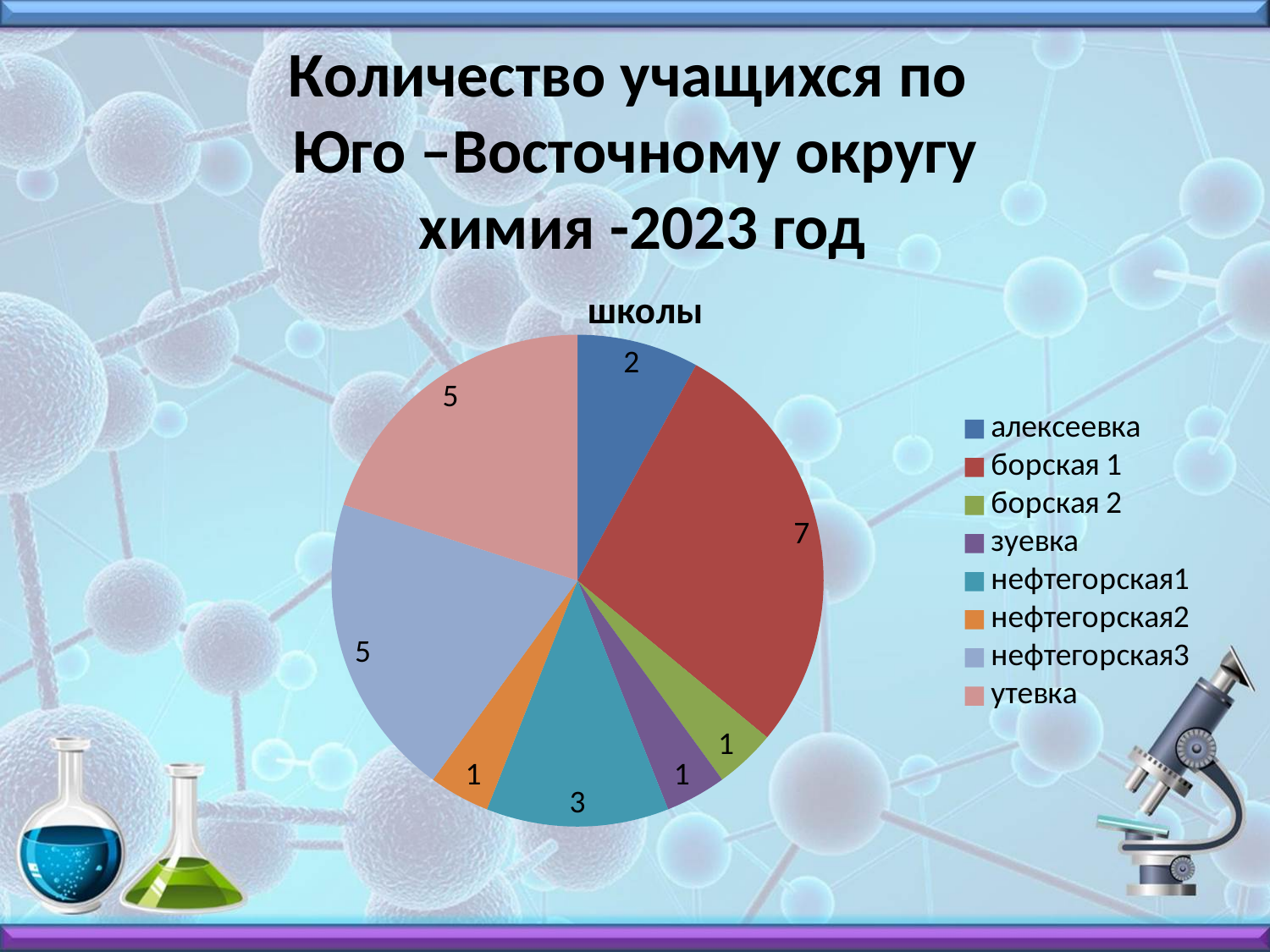
What is the value for утевка in the pie chart? 5 How many schools (slices) are shown in the pie chart? 8 What is the value for борская 1 in the pie chart? 7 What is the title of the pie chart? школы What share of the pie does борская 1 represent? 28% What is the value for нефтегорская1 in the pie chart? 3 Which school has the largest slice in the pie chart? борская 1 What is the total of all the values in the pie chart? 25 What type of chart is shown on the slide? pie chart What is the value for алексеевка in the pie chart? 2 What is the difference between the values for борская 1 and утевка? 2 Which is larger, the value for алексеевка or the value for нефтегорская1? нефтегорская1